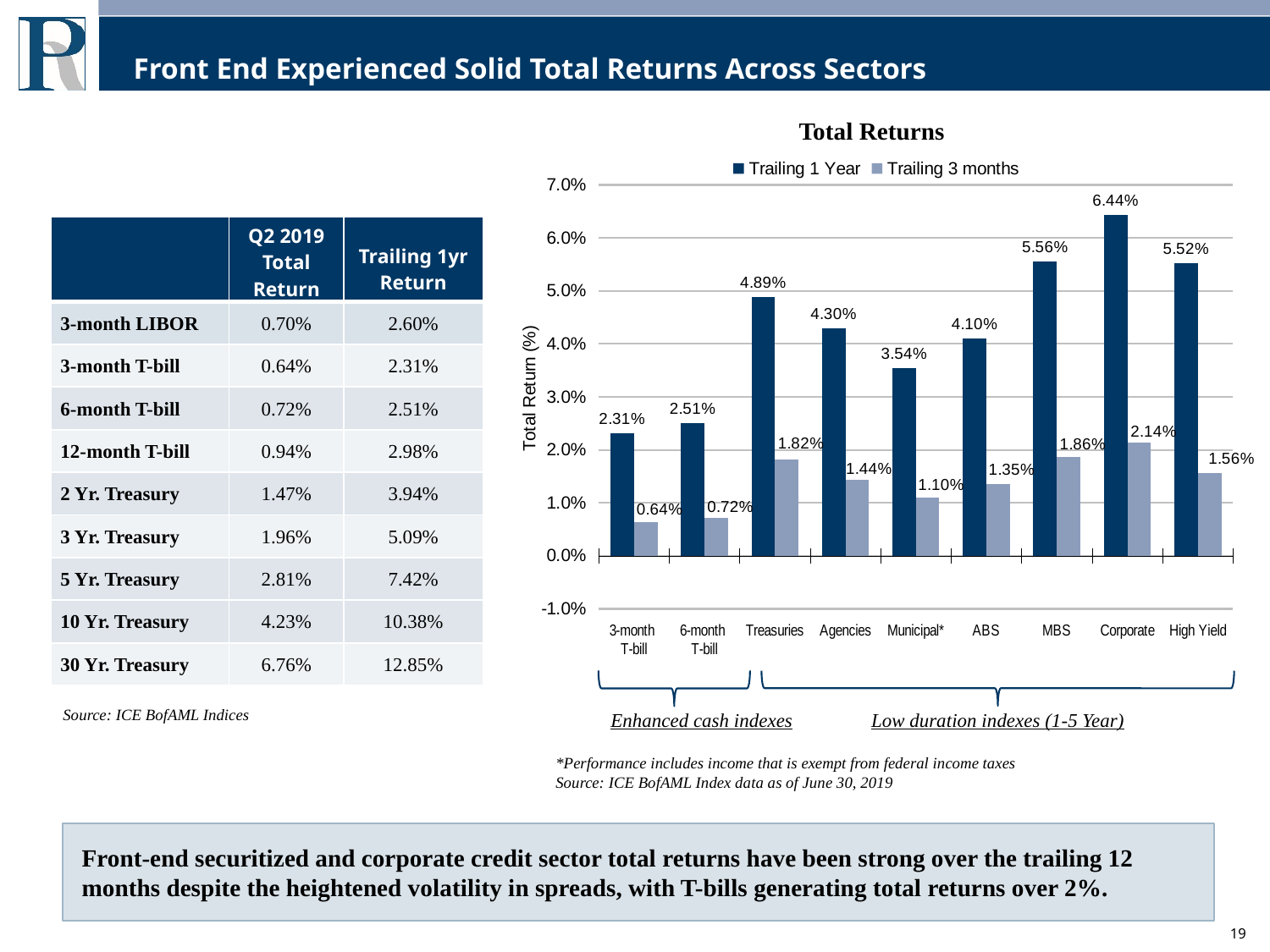
Which category has the lowest Trailing 3 months total return in the Total Returns chart? 3-month T-bill How many series does the legend of the Total Returns chart list? 2 Is the Trailing 1 Year return for Municipal* greater or less than 3.0% in the Total Returns chart? greater In the Total Returns chart, which has a higher Trailing 3 months return, Corporate or MBS? Corporate What is the label of the y axis in the Total Returns chart? Total Return (%) What is the difference between the Trailing 1 Year returns for MBS and High Yield in the Total Returns chart? 0.04% How many categories are shown on the x axis of the Total Returns chart? 9 Which category has the highest Trailing 1 Year total return in the Total Returns chart? Corporate What is the Trailing 3 months total return for Treasuries in the Total Returns chart? 1.82% What is the Trailing 1 Year total return for Corporate in the Total Returns chart? 6.44% What type of chart is the Total Returns chart? Bar chart What is the Trailing 1 Year return for Agencies in the Total Returns chart? 4.30%